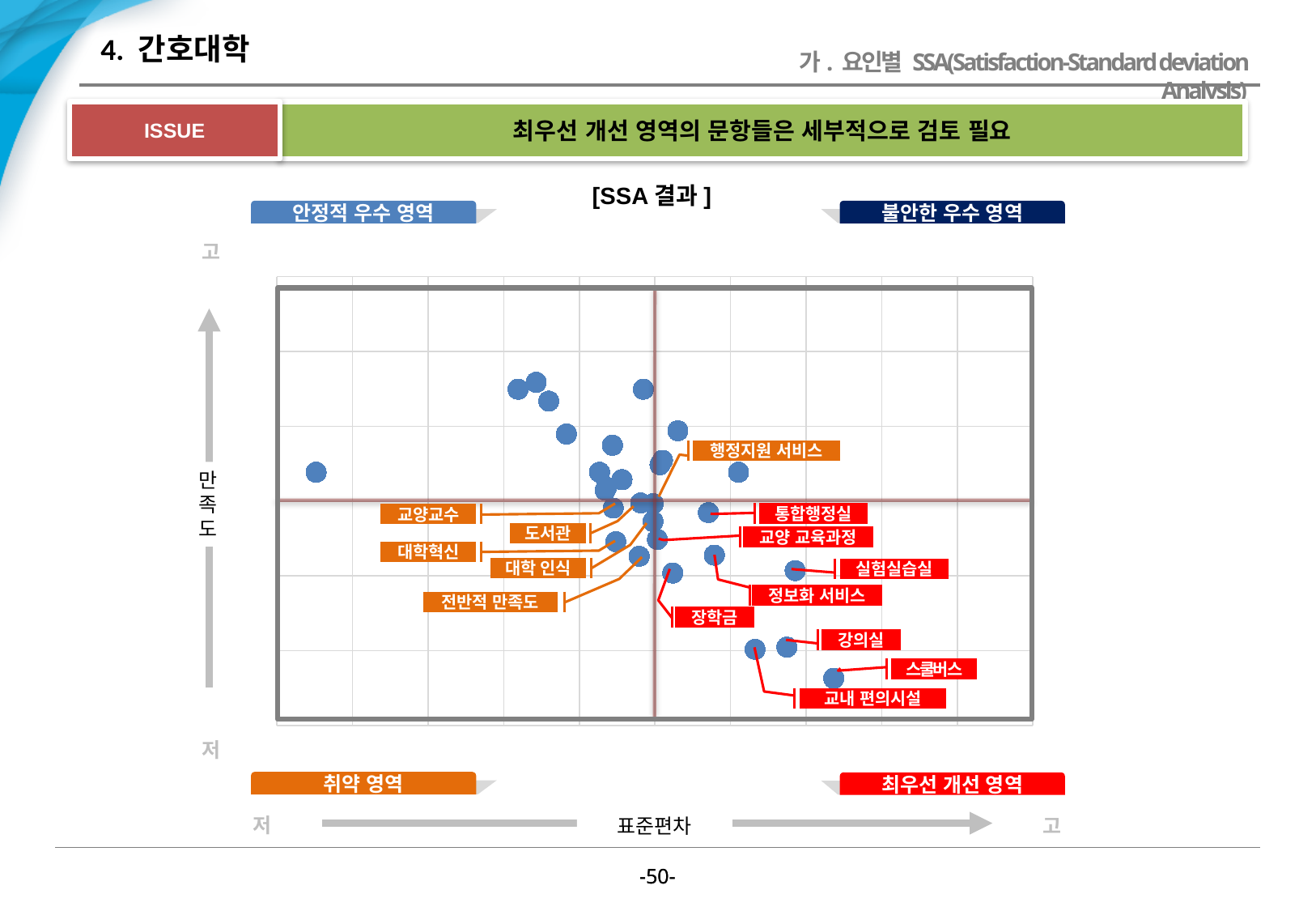
Which has the higher standard deviation (표준편차) value, 스쿨버스 or 강의실? 스쿨버스 How many points are labeled with orange labels in the chart? 6 Which has the higher satisfaction (만족도) value, 통합행정실 or 장학금? 통합행정실 Among the labeled points, which has the highest satisfaction (만족도) value? 행정지원 서비스 Which has the higher satisfaction (만족도) value, 행정지원 서비스 or 교내 편의시설? 행정지원 서비스 What is the title of the chart? [SSA 결과 ] What label is shown on the horizontal axis of the chart? 표준편차 What kind of chart is shown on the slide? scatter chart Among the labeled points, which has the lowest satisfaction (만족도) value? 스쿨버스 How many points are labeled with red labels in the chart? 8